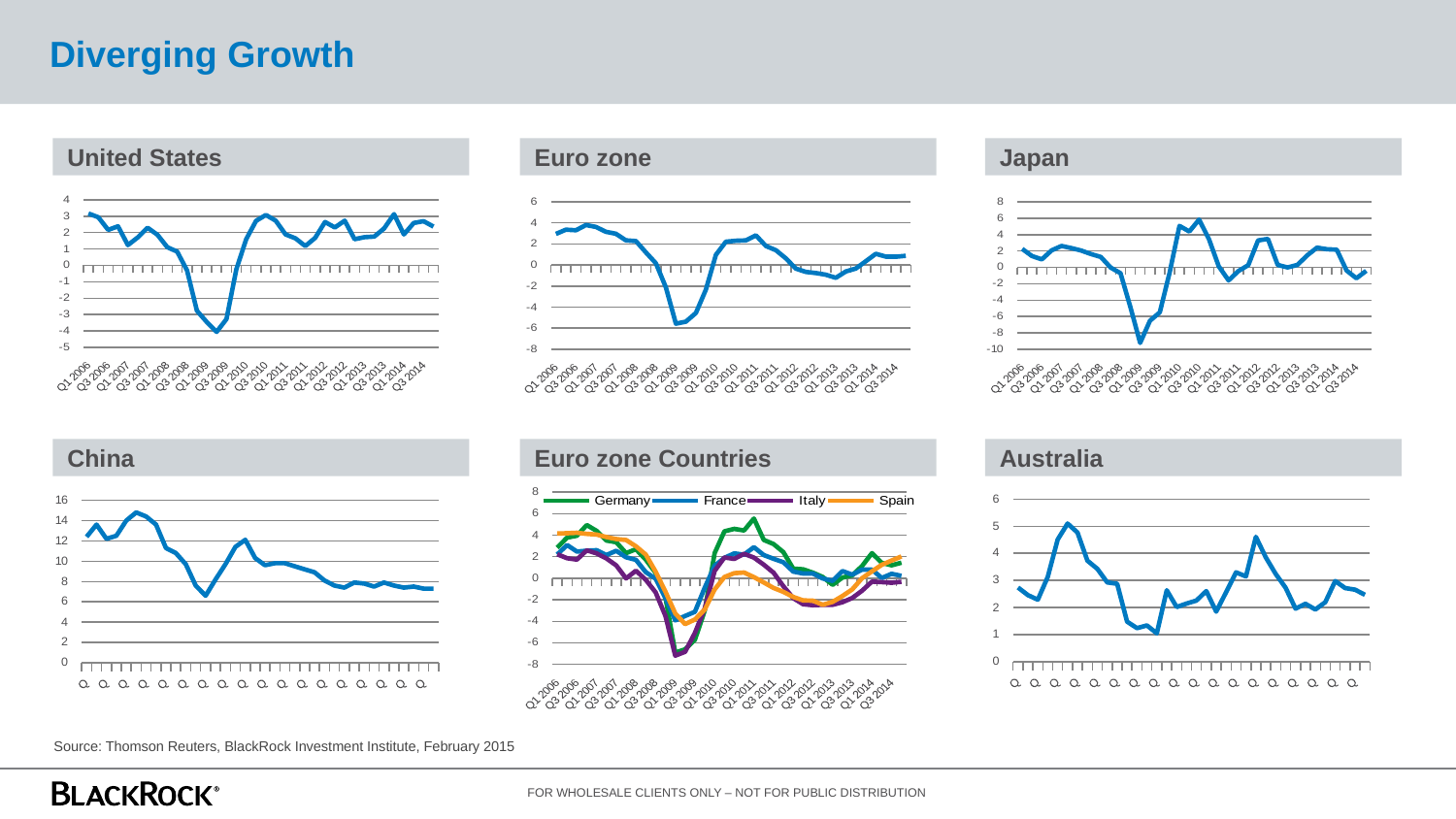
In the Japan chart, is the lowest value greater or less than -8? less Which series are listed in the legend of the Euro zone Countries chart? Germany, France, Italy, Spain In the Euro zone Countries chart, is the lowest value for Italy greater or less than -6? less In the China chart, is the highest value greater or less than 12? greater What kind of chart is the United States chart? Line chart How many charts are shown on the slide? 6 In the China chart, do the values generally rise or fall from the start to the end of the period? fall In the Euro zone Countries chart, what colour is the Spain line? Orange How many series does the legend of the Euro zone Countries chart list? 4